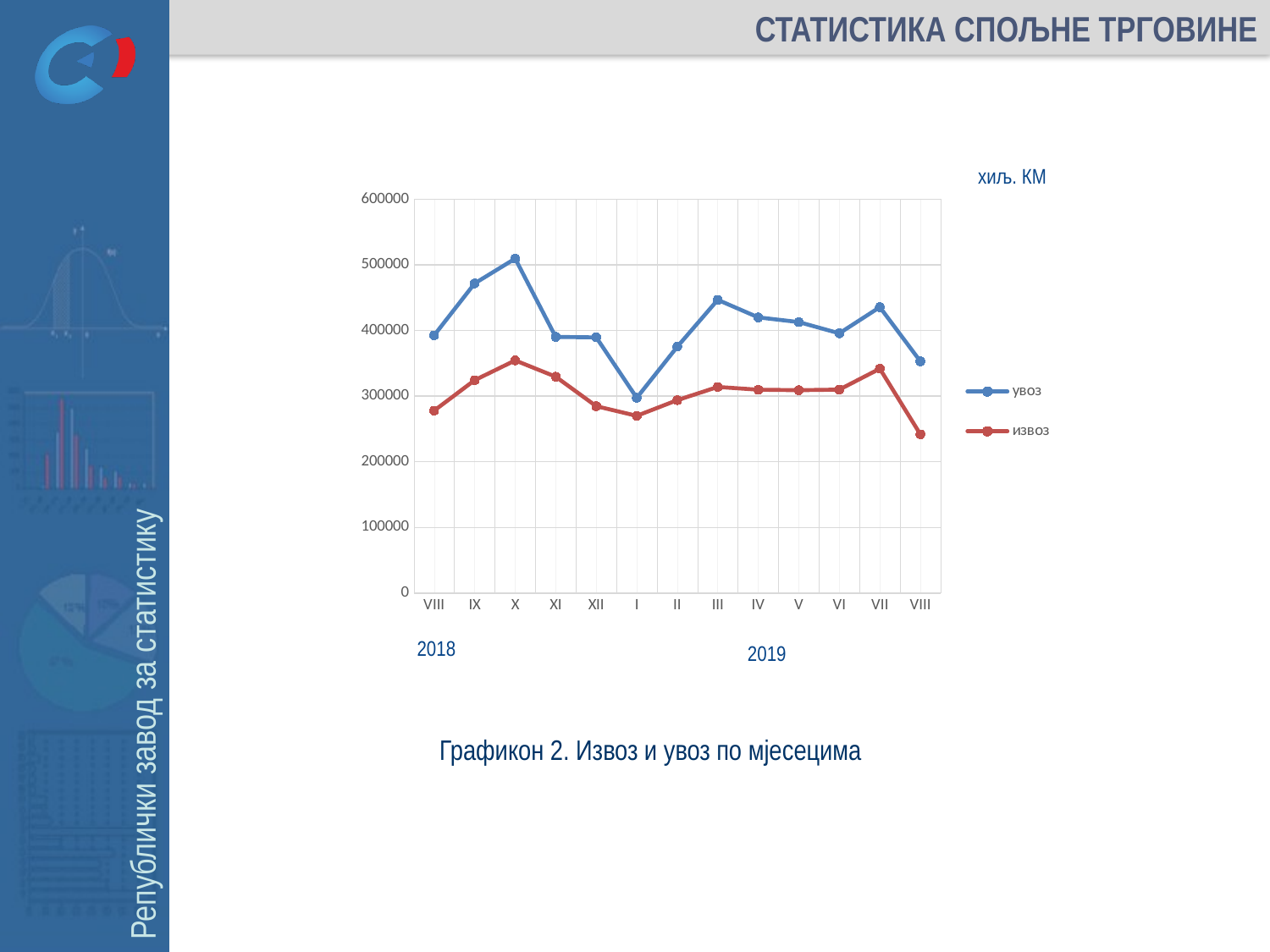
Is the value for извоз in VIII 2019 greater or less than 300000? less How many monthly points are plotted for each series? 13 In which month is the value for увоз highest? X (2018) In which month is the value for извоз highest? X (2018) Which series has the larger value in III 2019, увоз or извоз? увоз What kind of chart is shown on the slide? line chart Do the values for увоз rise or fall from VII 2019 to VIII 2019? fall How many series does the legend list? 2 In which month is the value for извоз lowest? VIII (2019) Is the value for увоз in X 2018 greater or less than 400000? greater In which month is the value for увоз lowest? I (2019) Is the value for извоз in X 2018 greater or less than 300000? greater